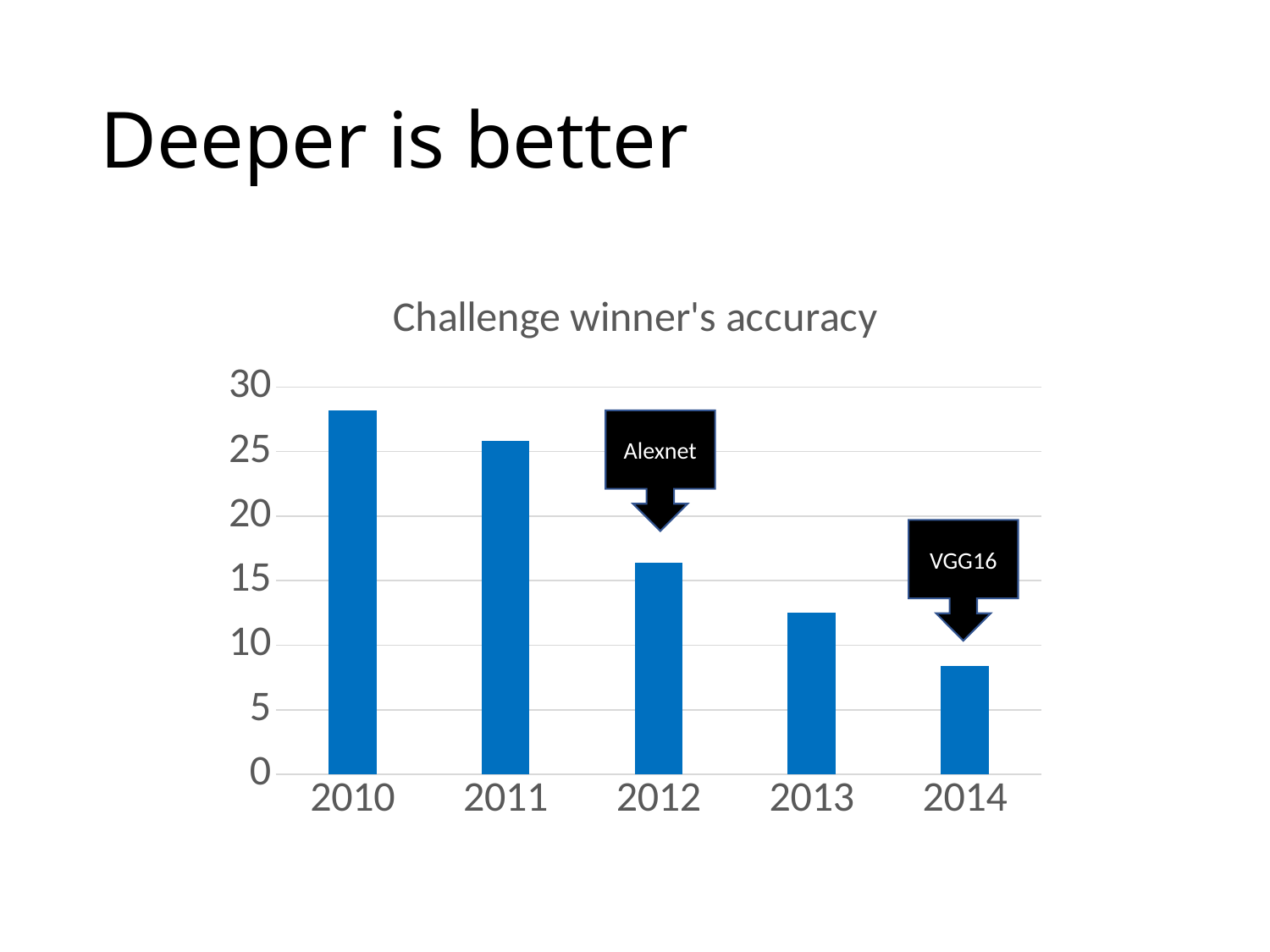
Do the values rise or fall from 2010 to 2014? fall Is the value for 2013 greater or less than 15? less Is the value for 2010 greater or less than 25? greater How many years are shown on the x axis of the chart? 5 What type of chart is shown on the slide? bar chart Which year has the highest bar in the chart? 2010 What is the title of the chart? Challenge winner's accuracy Which year has the lowest bar in the chart? 2014 Is the value for 2014 greater or less than 10? less Which year has the larger value, 2012 or 2013? 2012 Which model is labelled by the callout pointing at the 2012 bar? Alexnet